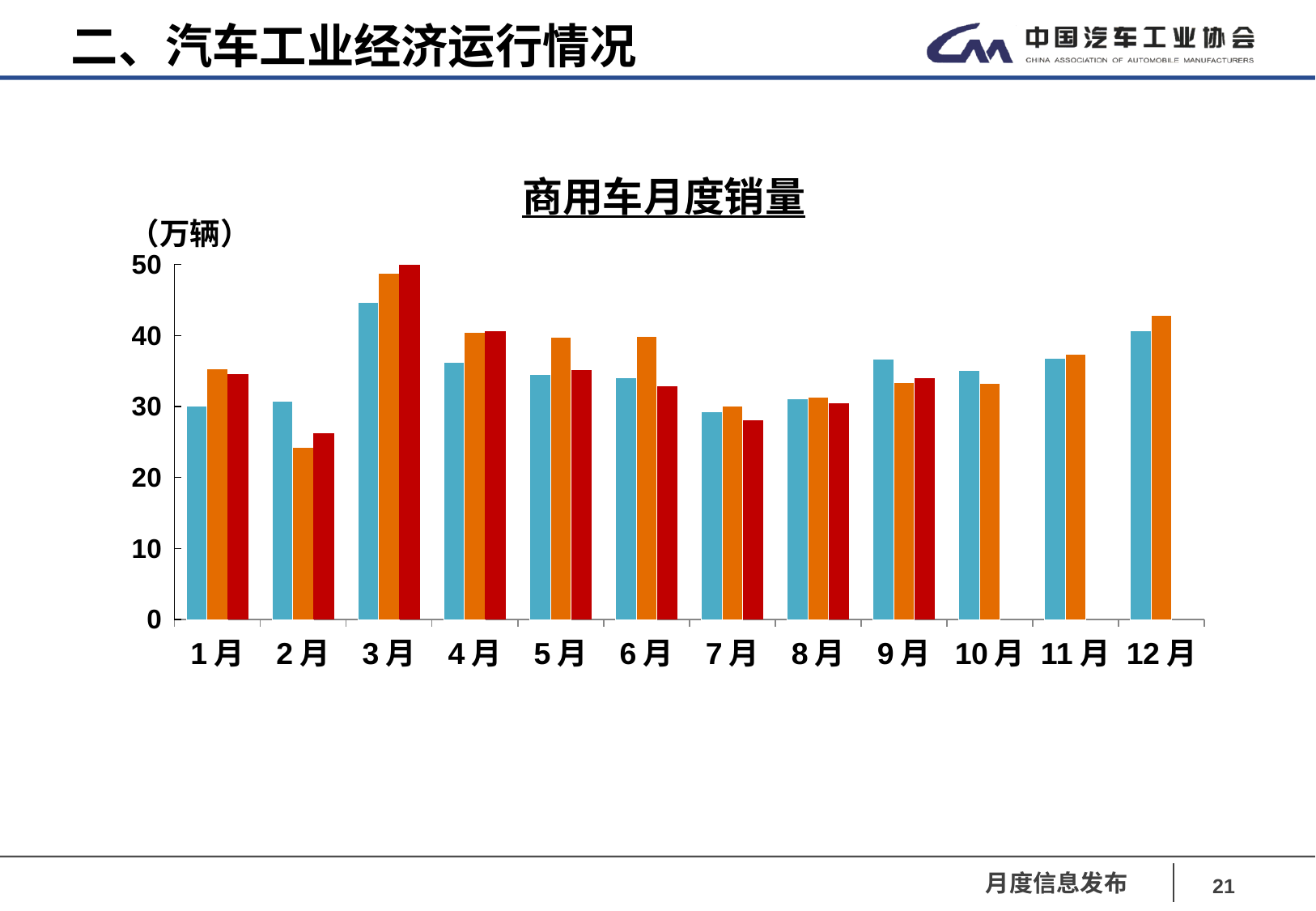
In which month is the red bar the highest? 3月 In 6月, which is larger, the orange bar or the red bar? the orange bar Is the red bar for 3月 greater or less than 40? greater In 2月, which is larger, the blue bar or the orange bar? the blue bar What kind of chart is shown on the slide? bar chart Is the orange bar for 2月 greater or less than 30? less What is the title of the chart? 商用车月度销量 In which month is the orange bar the lowest? 2月 Is the red bar for 7月 greater or less than 30? less Do the red bars rise or fall from 3月 to 7月? fall How many months are shown on the x axis of the chart? 12 What unit is shown for the y axis of the chart? 万辆